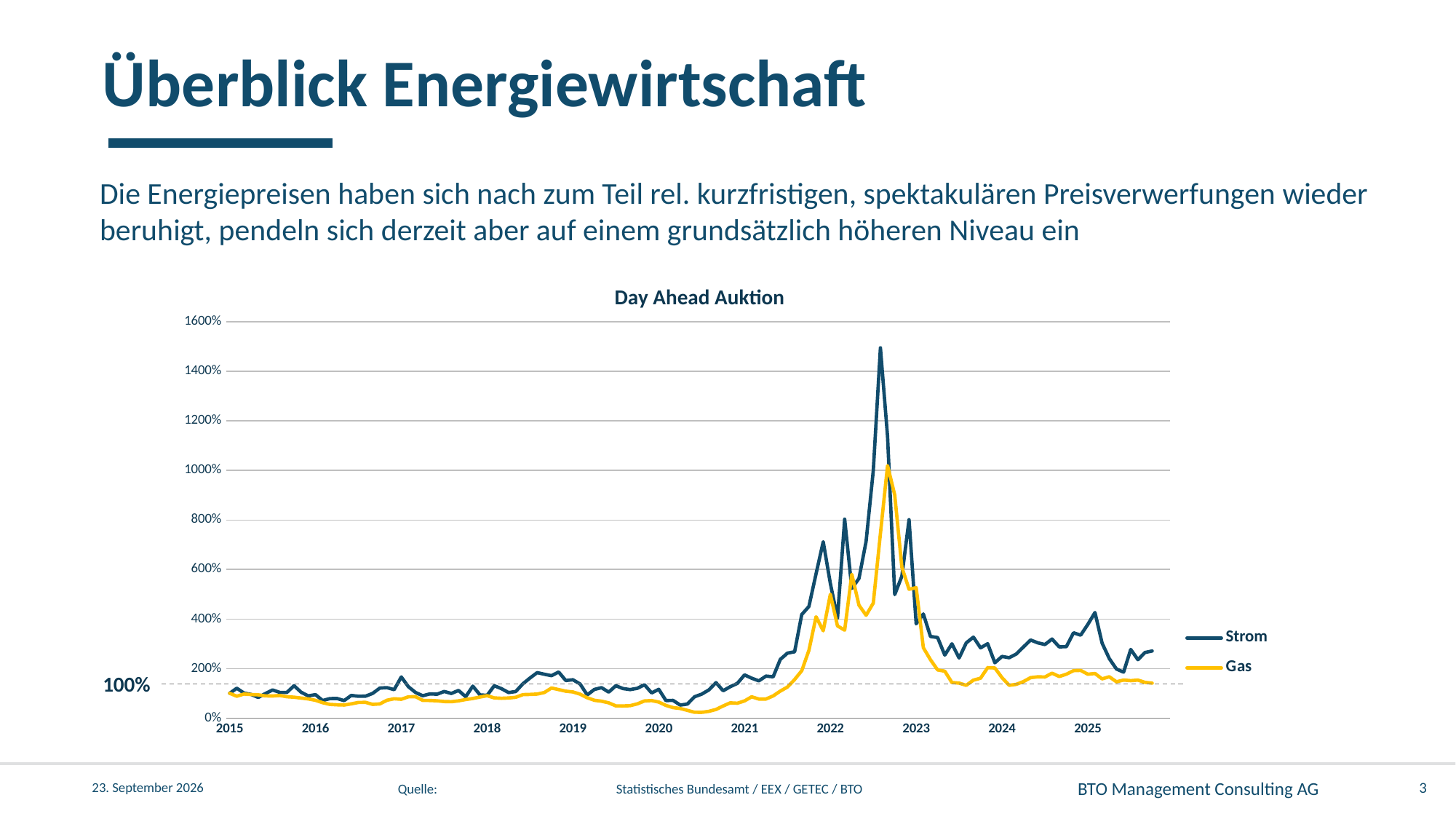
Is the value of the Gas series at the end of the plotted period (late 2025) greater or less than 200%? less Which series is drawn in yellow in the Day Ahead Auktion chart? Gas Is the peak value of the Gas series greater or less than 800%? greater What is the title of the chart? Day Ahead Auktion Which series reaches the higher peak in the Day Ahead Auktion chart, Strom or Gas? Strom How many year labels are shown on the x axis of the Day Ahead Auktion chart? 11 Which series is higher at the end of the plotted period, Strom or Gas? Strom Is the peak value of the Gas series greater or less than 1200%? less How many series does the legend of the Day Ahead Auktion chart list? 2 What kind of chart is shown on the slide? line chart